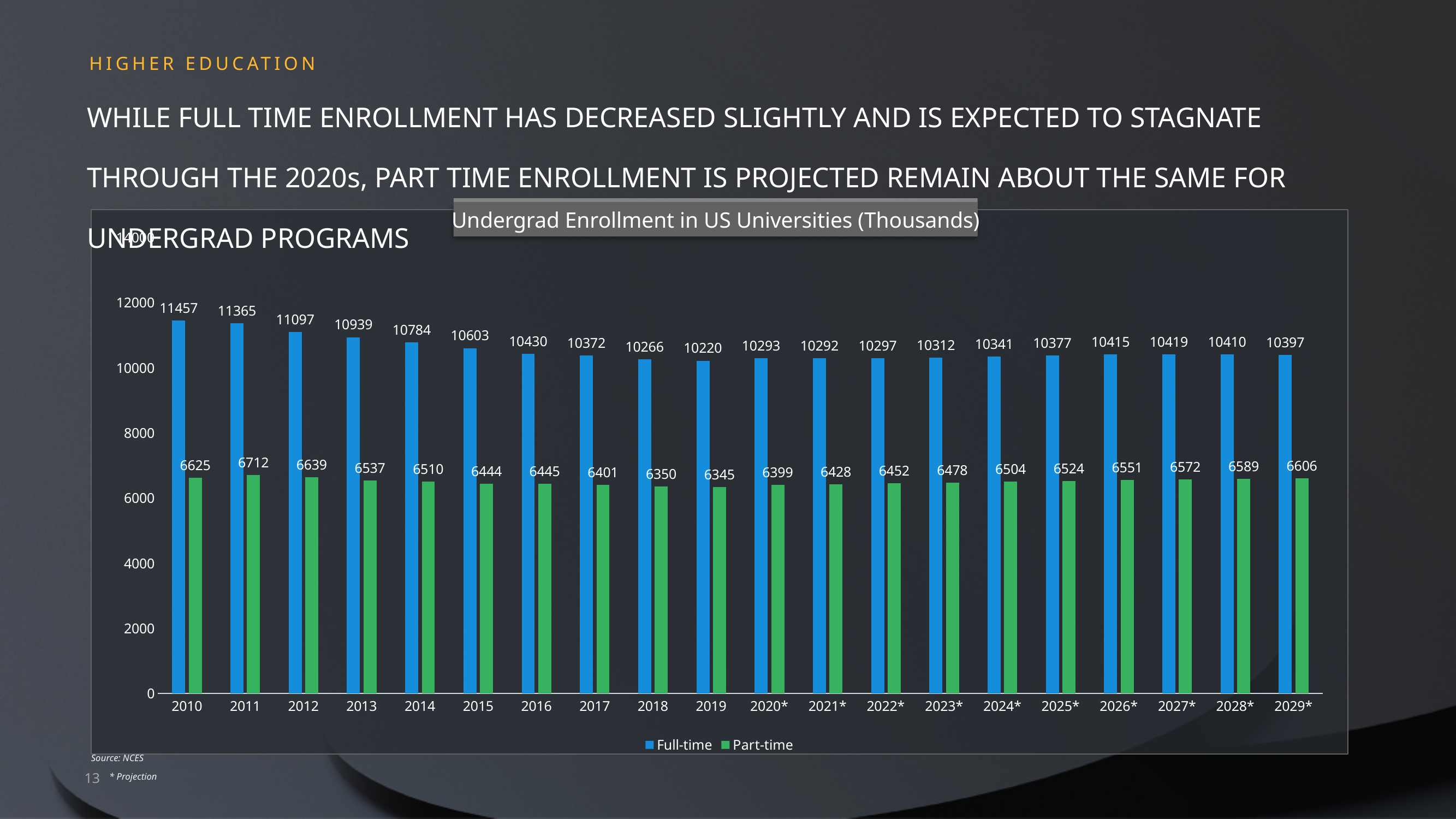
What is the difference between Full-time enrollment in 2010 and 2019? 1237 What is the Full-time enrollment value for 2010? 11457 How many series does the legend list? 2 Which year has the lowest Part-time enrollment? 2019 How many years are shown on the x axis? 20 What is the title of the chart? Undergrad Enrollment in US Universities (Thousands) Which year has the highest Part-time enrollment? 2011 What is the Part-time enrollment value for 2019? 6345 Which year has the highest Full-time enrollment? 2010 What kind of chart is shown on the slide? Bar chart What is the Full-time enrollment value for 2029*? 10397 Which is larger, Part-time enrollment in 2011 or in 2029*? 2011